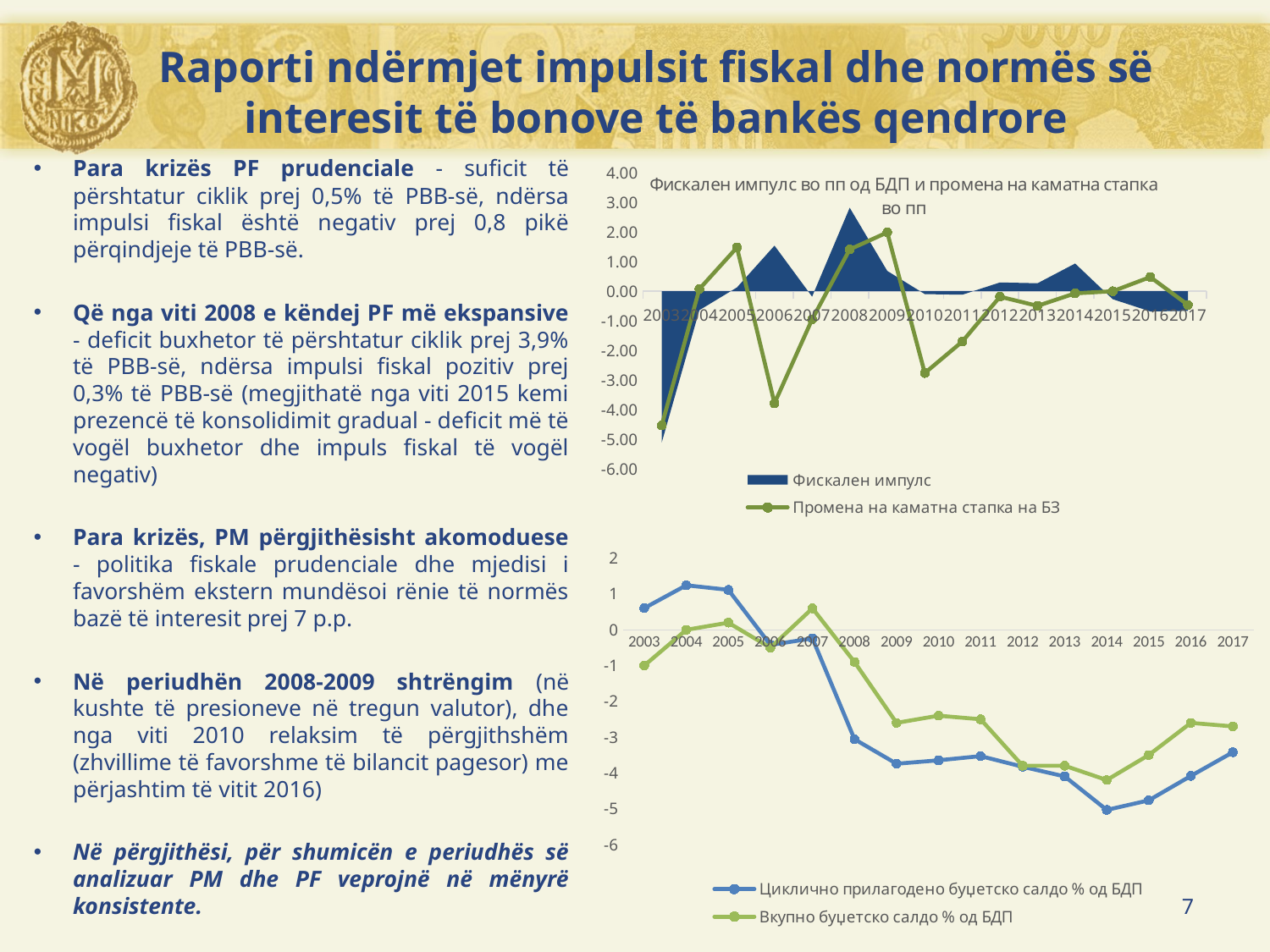
In the bottom chart, which series has the lower value in 2008: Циклично прилагодено буџетско салдо or Вкупно буџетско салдо? Циклично прилагодено буџетско салдо % од БДП In the top chart titled 'Фискален импулс во пп од БДП и промена на каматна стапка во пп', in which year is the Промена на каматна стапка на БЗ line at its lowest? 2003 In the bottom chart, is the value of Вкупно буџетско салдо in 2009 greater or less than -2? less What kind of chart is the bottom chart? line chart In the bottom chart, does the Циклично прилагодено буџетско салдо line rise or fall from 2014 to 2017? rise How many years are shown on the x axis of the bottom chart? 15 In the top chart titled 'Фискален импулс во пп од БДП и промена на каматна стапка во пп', in which year is the Фискален импулс highest? 2008 In the bottom chart, in which year does the Циклично прилагодено буџетско салдо line reach its lowest value? 2014 In the top chart titled 'Фискален импулс во пп од БДП и промена на каматна стапка во пп', is the Фискален импулс in 2008 greater or less than 2.00? greater In the bottom chart, is the value of Циклично прилагодено буџетско салдо in 2014 greater or less than -4? less How many series does the legend of the bottom chart list? 2 In the top chart titled 'Фискален импулс во пп од БДП и промена на каматна стапка во пп', which series has the larger value in 2006: Фискален импулс or Промена на каматна стапка на БЗ? Фискален импулс